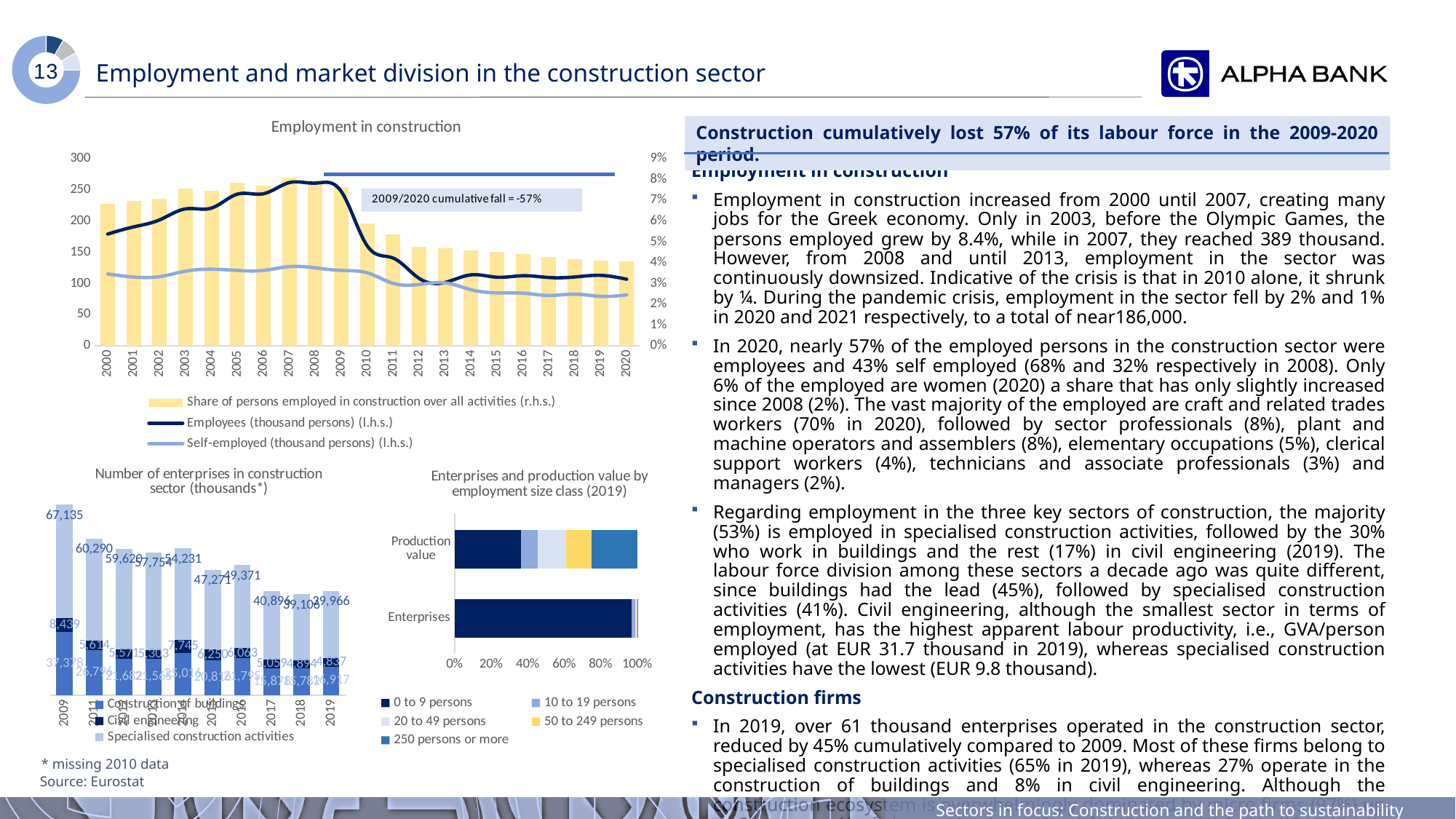
In the 'Employment in construction' chart, is the value for Employees (thousand persons) in 2000 greater or less than 150? greater In the 'Enterprises and production value by employment size class (2019)' chart, is the share of '0 to 9 persons' in the Enterprises bar greater or less than 80%? greater In the 'Employment in construction' chart, how many series does the legend list? 3 In the 'Number of enterprises in construction sector' chart, which year has the lowest value for Specialised construction activities? 2018 In the 'Number of enterprises in construction sector' chart, how many years (bars) are shown? 10 In the 'Number of enterprises in construction sector' chart, what is the value for Specialised construction activities in 2009? 67,135 In the 'Employment in construction' chart, what cumulative fall for 2009/2020 is stated in the annotation box? -57% In the 'Number of enterprises in construction sector' chart, which year has the highest value for Specialised construction activities? 2009 In the 'Number of enterprises in construction sector' chart, what is the difference between the Specialised construction activities values for 2009 and 2019? 27,169 In the 'Employment in construction' chart, do the Employees (thousand persons) values rise or fall from 2009 to 2013? fall In the 'Enterprises and production value by employment size class (2019)' chart, how many size classes does the legend list? 5 In the 'Employment in construction' chart, how many years are shown on the x axis? 21